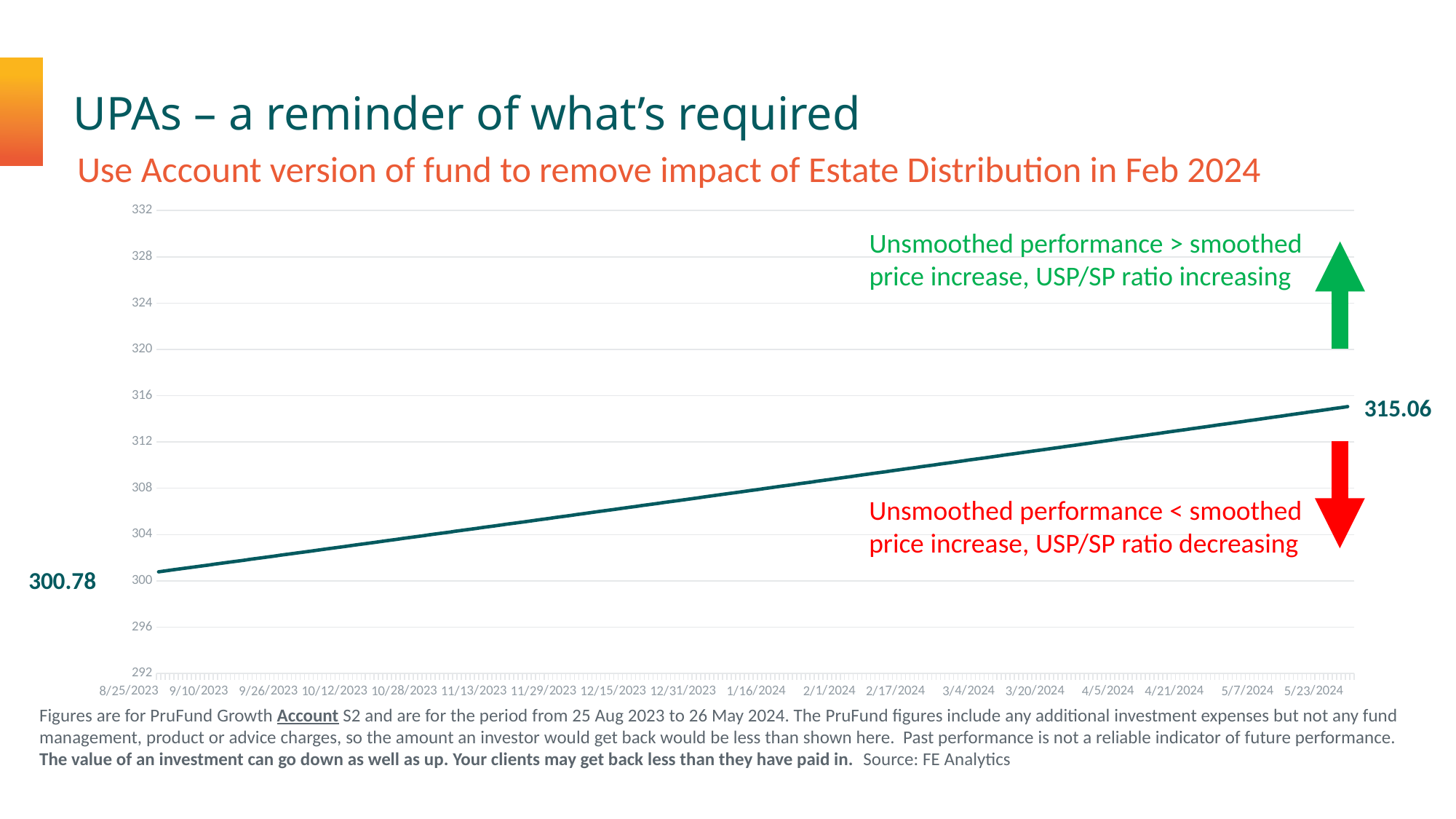
What source is cited for the chart data? FE Analytics Is the value of the line at 10/12/2023 greater or less than 308? less What is the difference between the end value and the start value of the line? 14.28 What is the highest value shown on the vertical axis? 332 Which of the two labelled values is larger, the start value or the end value? the end value (315.06) What kind of chart is shown on the slide? line chart Is the value of the line at 1/16/2024 greater or less than 312? less Does the line rise or fall from left to right across the chart? rises How many date labels are shown along the x axis? 18 What is the value labelled at the end of the line? 315.06 What is the value labelled at the start of the line (8/25/2023)? 300.78 Is the value of the line at 1/16/2024 greater or less than 304? greater